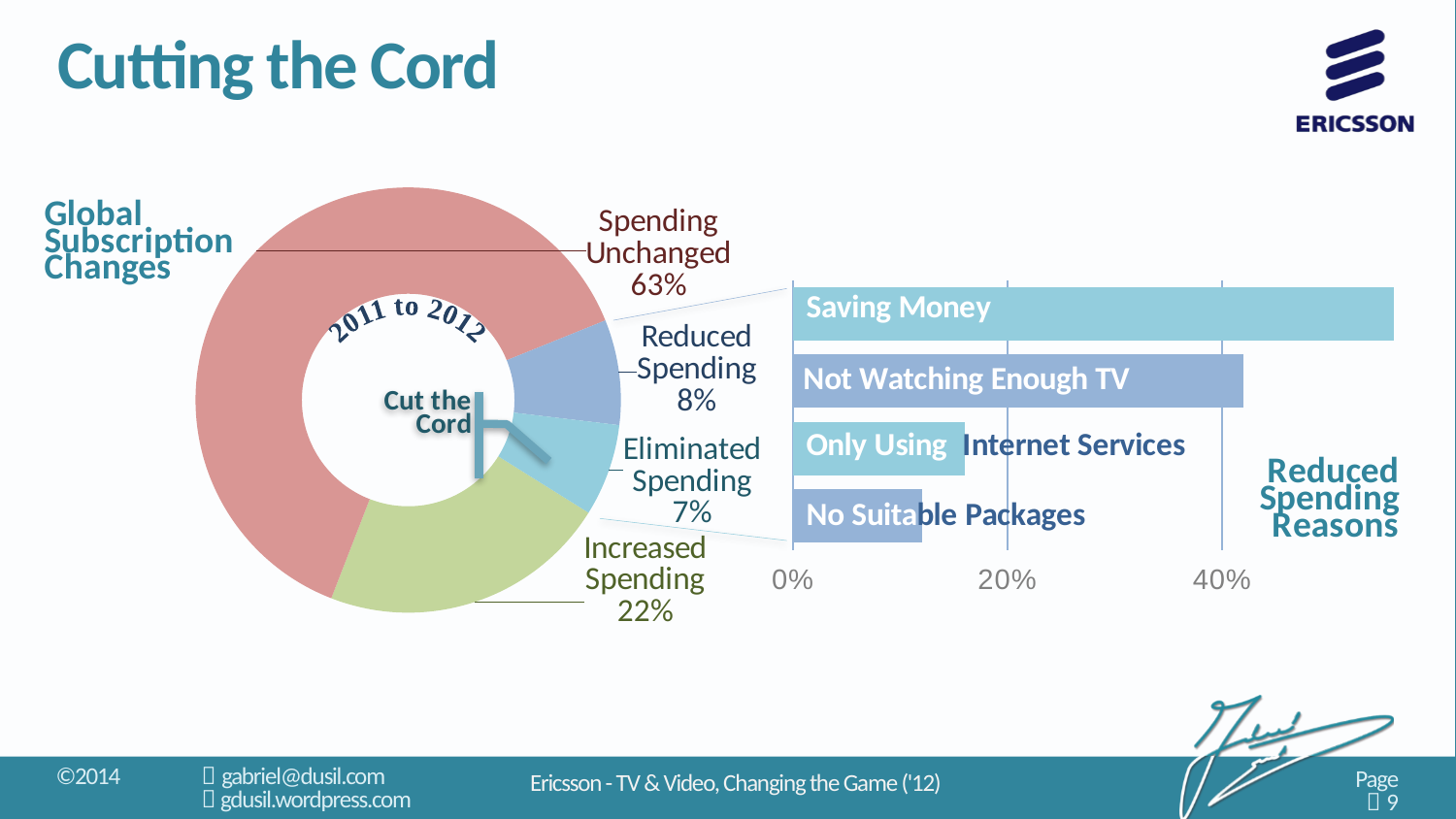
In the Reduced Spending Reasons chart, which reason has the longest bar? Saving Money In the Global Subscription Changes donut chart, what share is Spending Unchanged? 63% In the Global Subscription Changes donut chart, what share is Eliminated Spending? 7% In the Reduced Spending Reasons chart, is the value for Saving Money greater or less than 40%? greater In the Global Subscription Changes donut chart, which period do the data cover? 2011 to 2012 In the Global Subscription Changes donut chart, which category has the smallest share? Eliminated Spending In the Reduced Spending Reasons chart, which reason has the shortest bar? No Suitable Packages In the Global Subscription Changes donut chart, how many categories are shown? 4 In the Global Subscription Changes donut chart, which category has the largest share? Spending Unchanged What kind of chart is the Reduced Spending Reasons chart? bar chart In the Global Subscription Changes donut chart, what share is Increased Spending? 22% In the Global Subscription Changes donut chart, what is the difference between Increased Spending and Reduced Spending? 14%